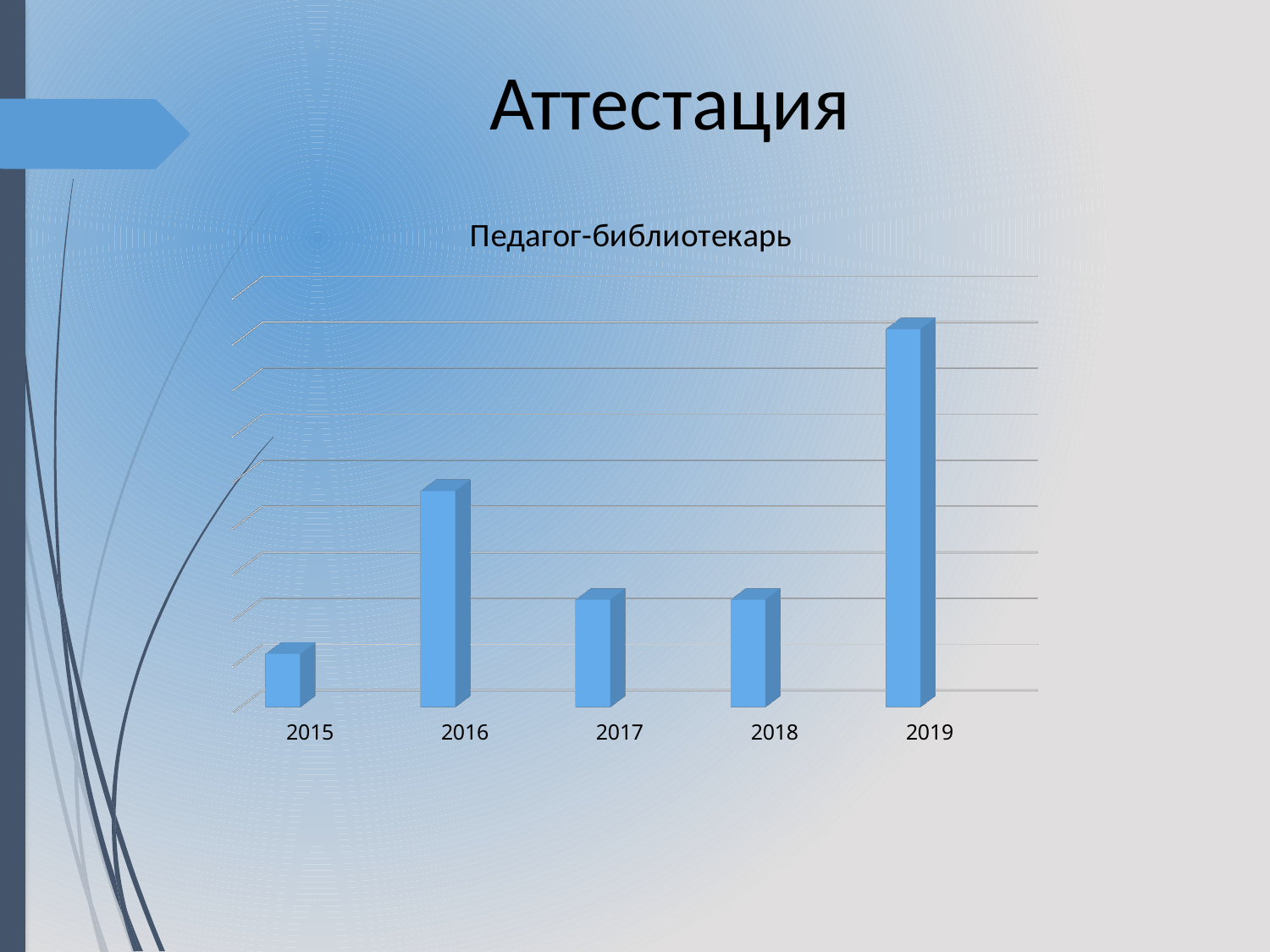
Which year has the highest bar in the chart? 2019 What kind of chart is shown on the slide? bar chart Does the value rise or fall from 2015 to 2016? rise Which year has the lowest bar in the chart? 2015 Which year has the larger value, 2019 or 2016? 2019 Which year has the larger value, 2016 or 2017? 2016 Does the value rise or fall from 2016 to 2017? fall What is the title of the chart? Педагог-библиотекарь Which year has the larger value, 2015 or 2018? 2018 Does the value rise or fall from 2018 to 2019? rise How many years (categories) are shown on the x axis of the chart? 5 Which year has the second highest bar in the chart? 2016